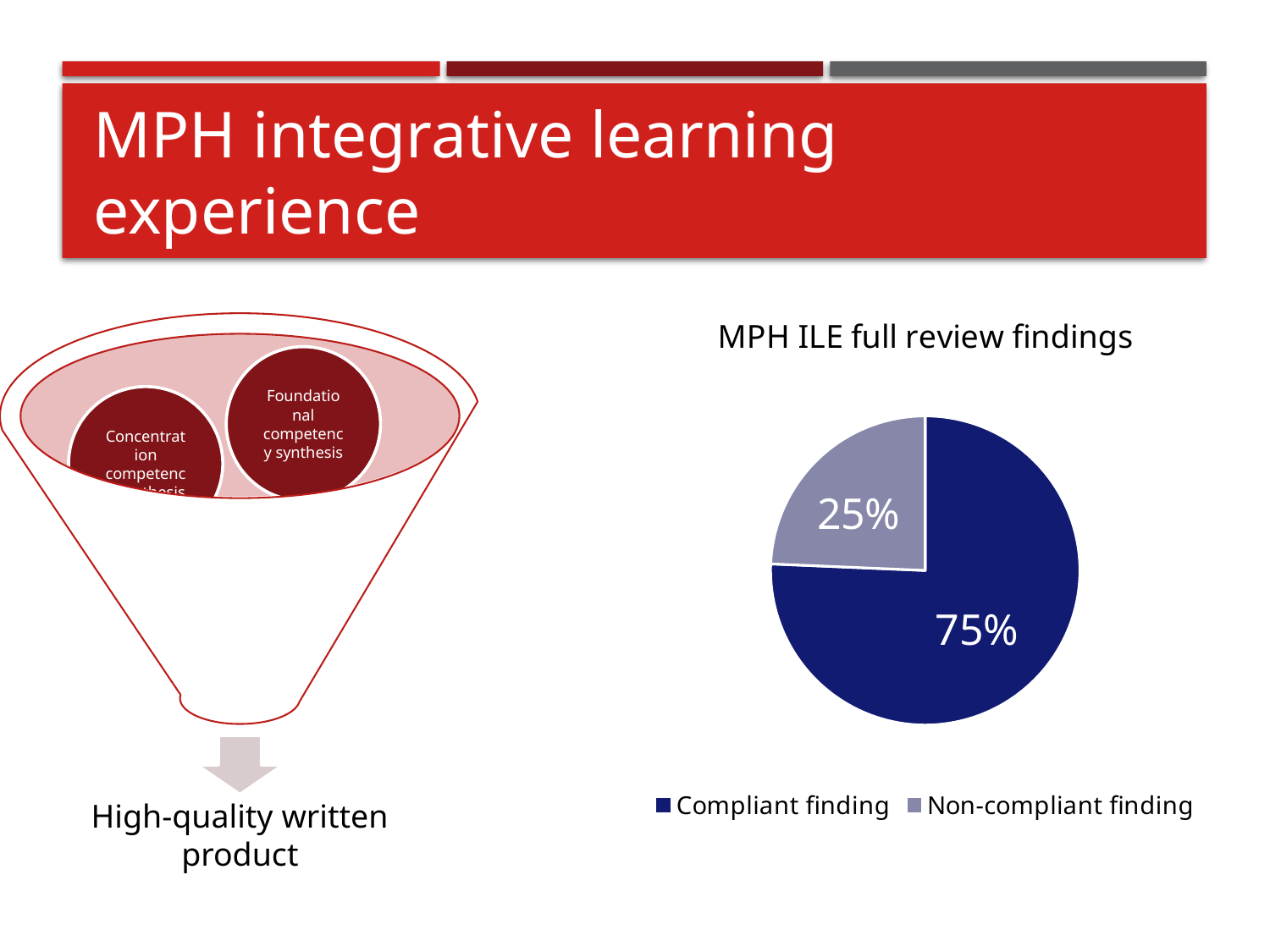
What is the title of the pie chart on the slide? MPH ILE full review findings In the 'MPH ILE full review findings' pie chart, which category has the smallest slice? Non-compliant finding In the 'MPH ILE full review findings' pie chart, what share is labelled for Non-compliant finding? 25% What kind of chart is shown under the title 'MPH ILE full review findings'? pie chart In the 'MPH ILE full review findings' pie chart, what is the difference in percentage points between Compliant finding and Non-compliant finding? 50 percentage points In the 'MPH ILE full review findings' pie chart, what share is labelled for Compliant finding? 75% How many slices does the 'MPH ILE full review findings' pie chart have? 2 In the 'MPH ILE full review findings' pie chart, which category has the largest slice? Compliant finding In the 'MPH ILE full review findings' pie chart, which category is shown in dark blue? Compliant finding How many entries does the legend of the 'MPH ILE full review findings' pie chart list? 2 In the 'MPH ILE full review findings' pie chart, which is larger: Compliant finding or Non-compliant finding? Compliant finding